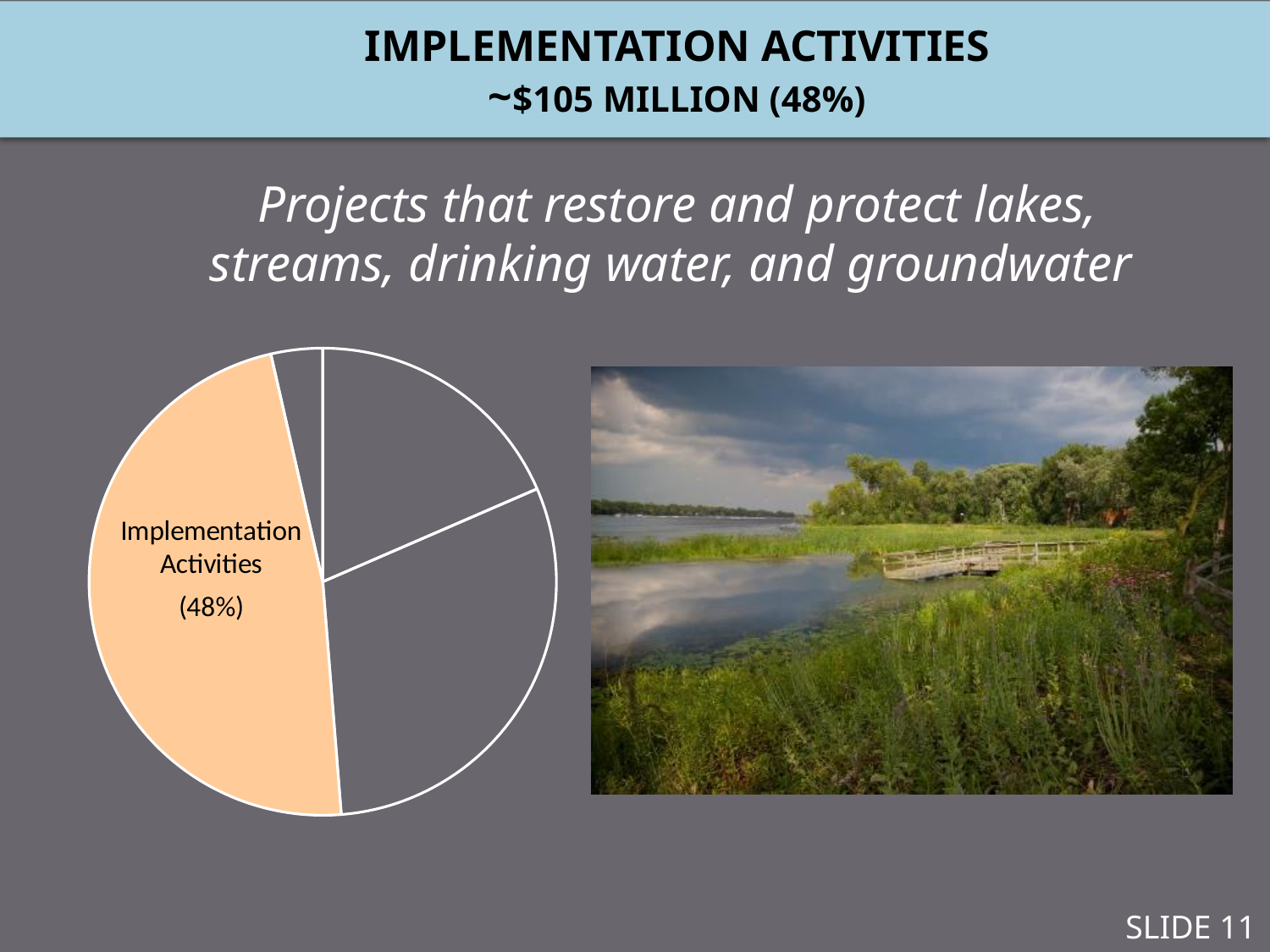
Which slice of the pie chart is the largest? Implementation Activities According to the slide title, what dollar amount corresponds to the 48% Implementation Activities slice? ~$105 million Which slice of the pie chart is labeled? Implementation Activities Is the Implementation Activities slice greater or less than 50% of the pie? less What kind of chart is shown on the slide? pie chart How many slices does the pie chart have? 4 What colour is the Implementation Activities slice? orange What share of the pie does the Implementation Activities slice represent? 48%